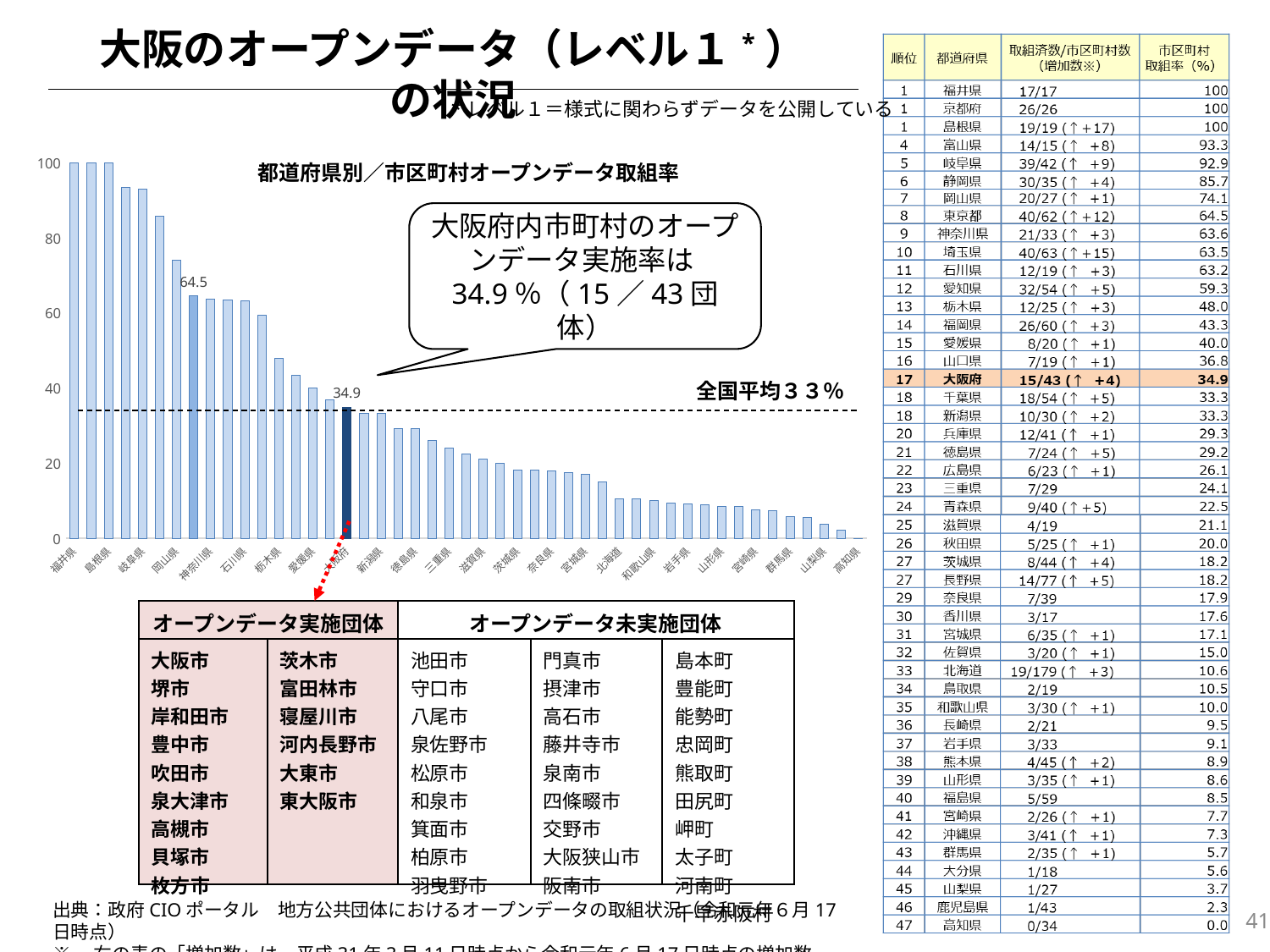
Is the value for 北海道 greater or less than 20? less Is the value for 福井県 greater or less than 80? greater Which has the larger value in the chart, 神奈川県 or 大阪府? 神奈川県 Which prefecture has the lowest value in the chart? 高知県 Do the bar values rise or fall from left to right along the x axis? fall Is the value for 岡山県 greater or less than 60? greater What value is labelled on the bar for 大阪府 in the chart? 34.9 What national average value is marked by the dashed line in the chart? 33% What is the title of the chart? 都道府県別／市区町村オープンデータ取組率 What type of chart is shown on the slide? bar chart